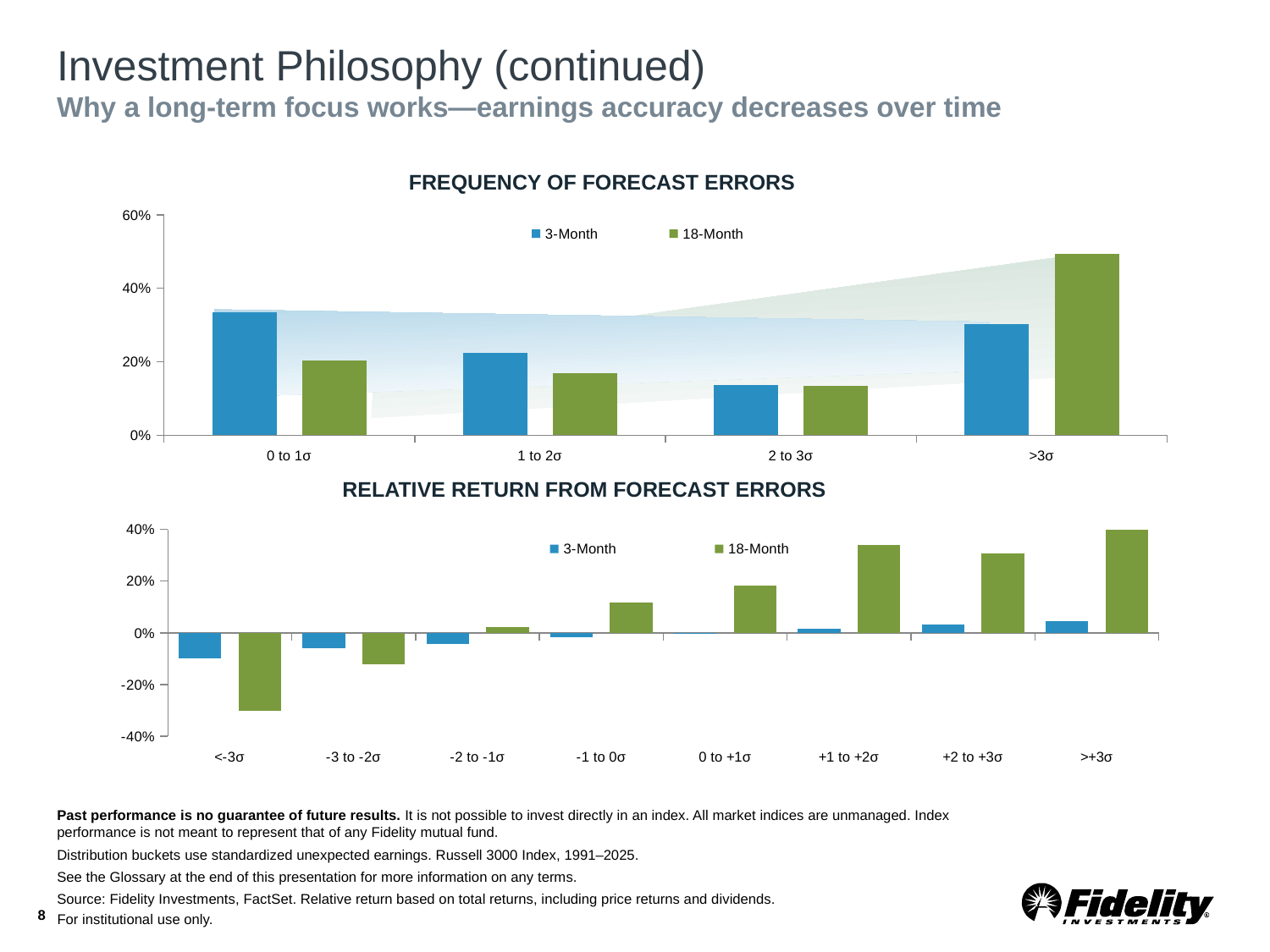
In the 'Frequency of Forecast Errors' chart, which category has the highest 18-Month value? >3σ In the 'Frequency of Forecast Errors' chart, for the 0 to 1σ category, which series has the larger value, 3-Month or 18-Month? 3-Month In the 'Relative Return from Forecast Errors' chart, is the 18-Month value for <-3σ greater or less than -20%? less In the 'Frequency of Forecast Errors' chart, is the 18-Month value for >3σ greater or less than 40%? greater In the 'Frequency of Forecast Errors' chart, how many categories are shown on the x axis? 4 In the 'Relative Return from Forecast Errors' chart, which category has the highest 18-Month value? >+3σ What kind of chart is the 'Frequency of Forecast Errors' chart? bar chart In the 'Relative Return from Forecast Errors' chart, how many categories are shown on the x axis? 8 In the 'Frequency of Forecast Errors' chart, how many series does the legend list? 2 In the 'Relative Return from Forecast Errors' chart, what colour represents the 18-Month series? green In the 'Relative Return from Forecast Errors' chart, which category has the lowest 18-Month value? <-3σ In the 'Frequency of Forecast Errors' chart, is the 3-Month value for 0 to 1σ greater or less than 20%? greater